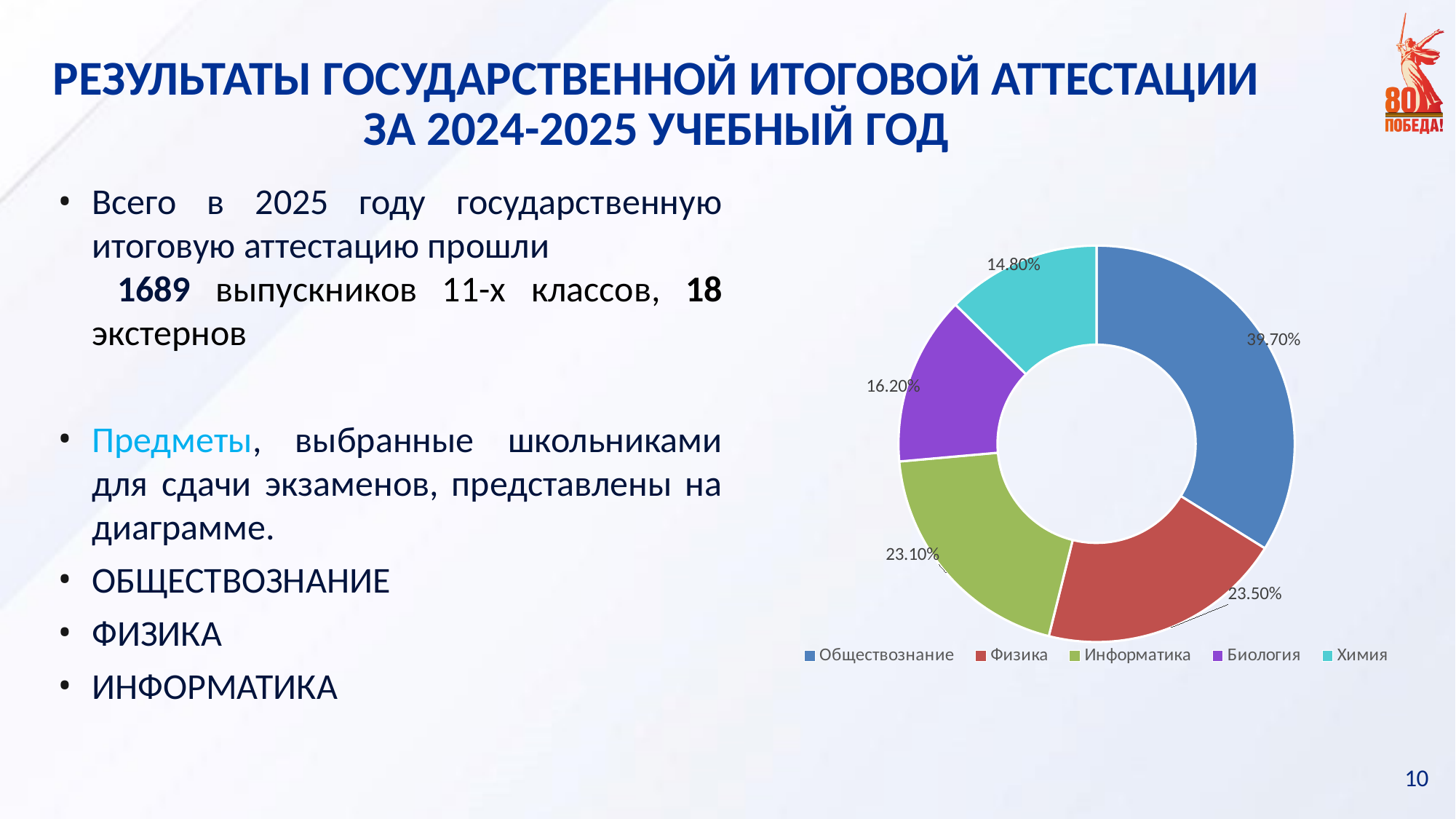
What is the value shown for Химия? 14.80% Which subject has the smallest share of the chart? Химия What kind of chart is shown on the slide? Pie chart (doughnut) How many subjects are shown in the chart? 5 Which subject has the largest share of the chart? Обществознание What share of the pie does Обществознание have? 39.70% What is the difference between the shares of Обществознание and Физика? 16.20% What colour is the Информатика segment in the chart? Green What is the value shown for Биология? 16.20% Which has a larger share, Биология or Химия? Биология What is the value shown for Информатика? 23.10% What is the value shown for Физика? 23.50%